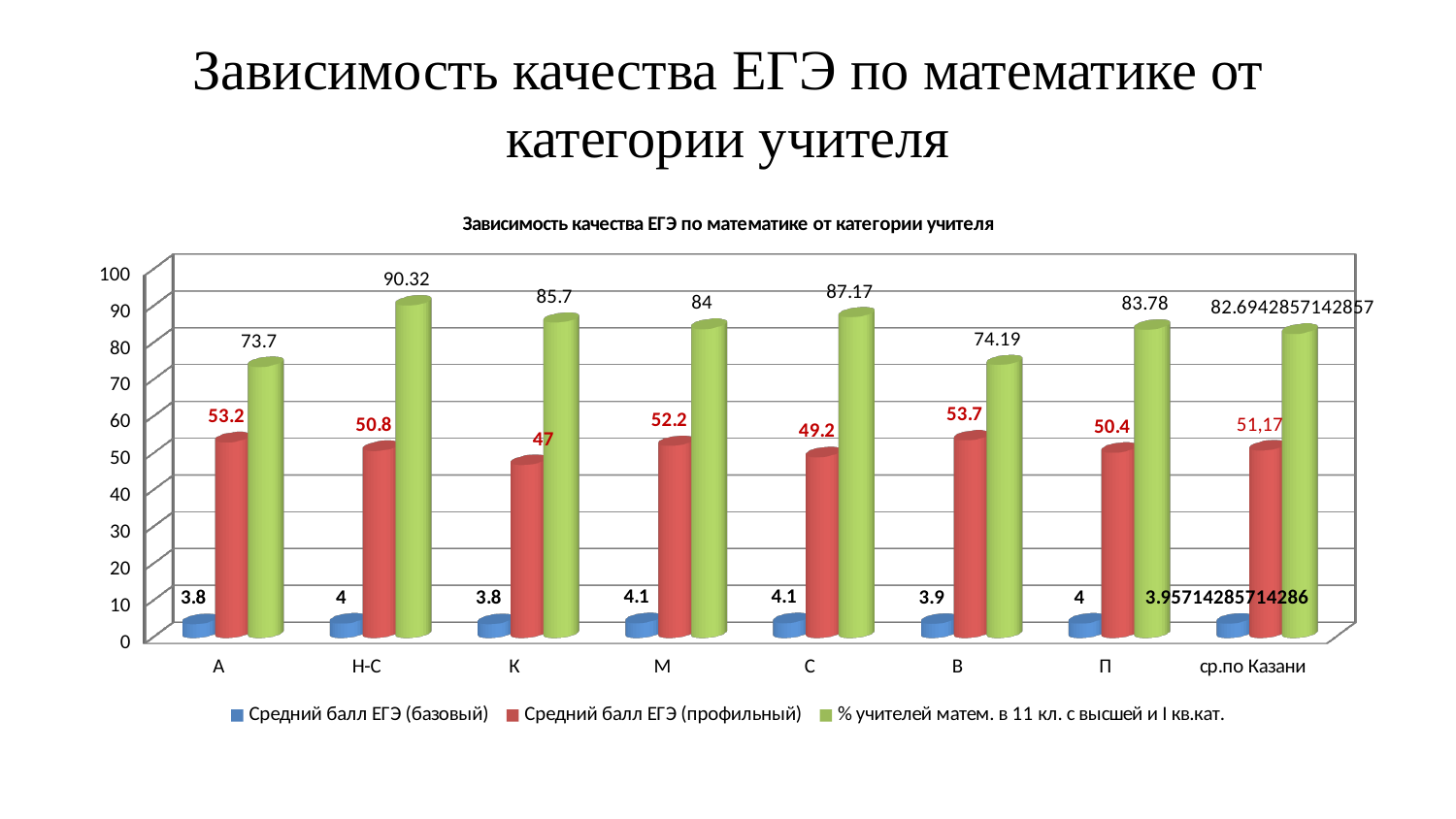
Is the value of '% учителей матем. в 11 кл. с высшей и I кв.кат.' for category В greater or less than 80? less What is the difference between the '% учителей матем. в 11 кл. с высшей и I кв.кат.' values for Н-С and А? 16.62 How many series does the legend list? 3 Which category has the highest value for '% учителей матем. в 11 кл. с высшей и I кв.кат.'? Н-С Which category has the lowest value for 'Средний балл ЕГЭ (профильный)'? К What type of chart is shown on the slide? bar chart What is the value of 'Средний балл ЕГЭ (профильный)' for category П? 50.4 What is the value of 'Средний балл ЕГЭ (профильный)' for category А? 53.2 What is the value of 'Средний балл ЕГЭ (базовый)' for category М? 4.1 Which is larger: the 'Средний балл ЕГЭ (профильный)' value for В or for С? В What is the value of '% учителей матем. в 11 кл. с высшей и I кв.кат.' for category Н-С? 90.32 How many categories are shown on the x axis? 8